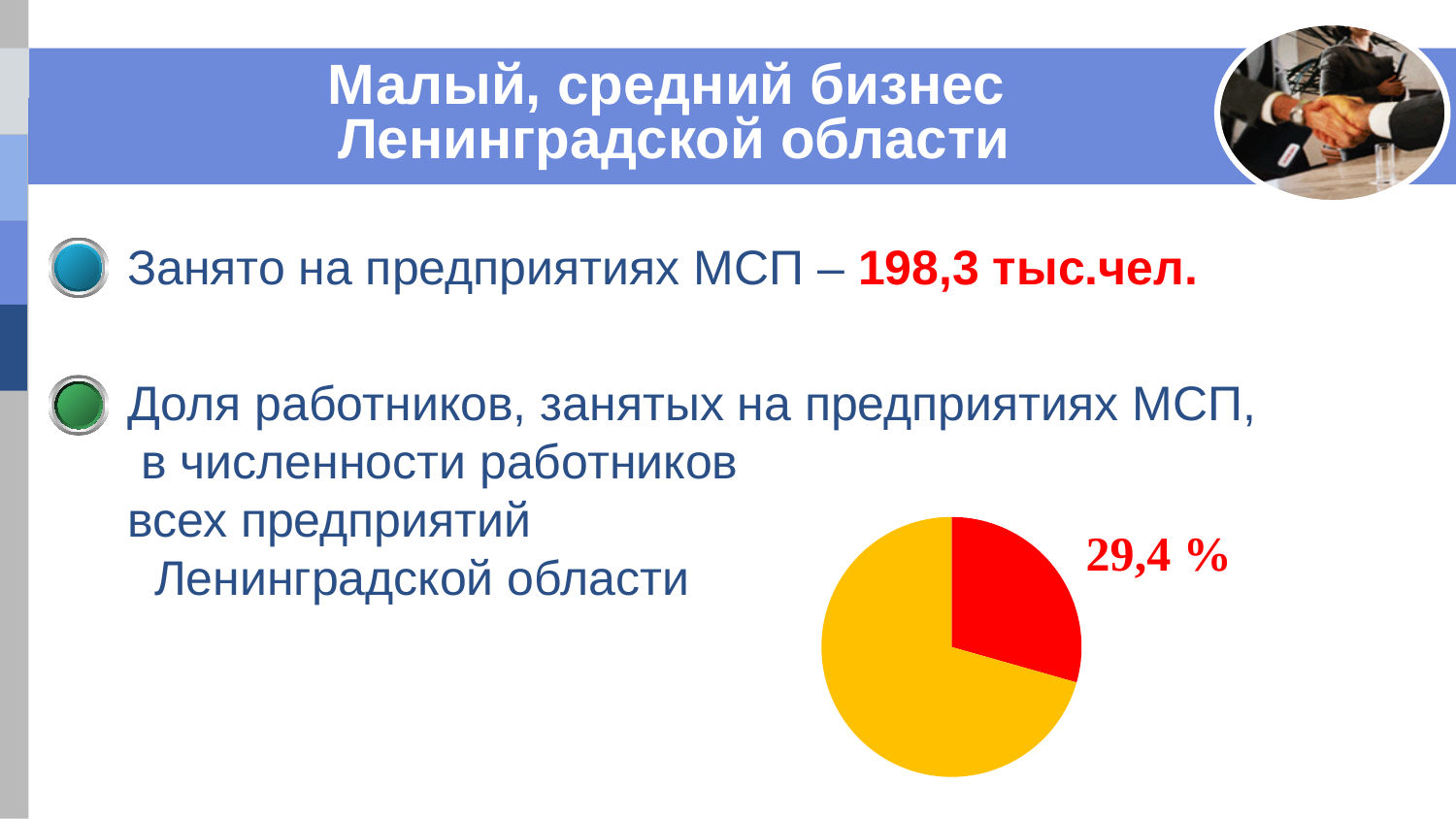
What share of the pie does the red slice represent? 29,4 % What colour is the slice of the pie chart that carries the data label? red According to the slide, what share of workers of all enterprises of the Leningrad region is employed at SME enterprises, as shown by the pie chart? 29,4 % Which slice of the pie chart is the smallest? red What kind of chart is shown on the slide? pie chart What value is printed next to the red slice of the pie chart? 29,4 % Which slice of the pie chart is larger, the red one or the yellow one? yellow Which slice of the pie chart is the largest? yellow How many slices does the pie chart have? 2